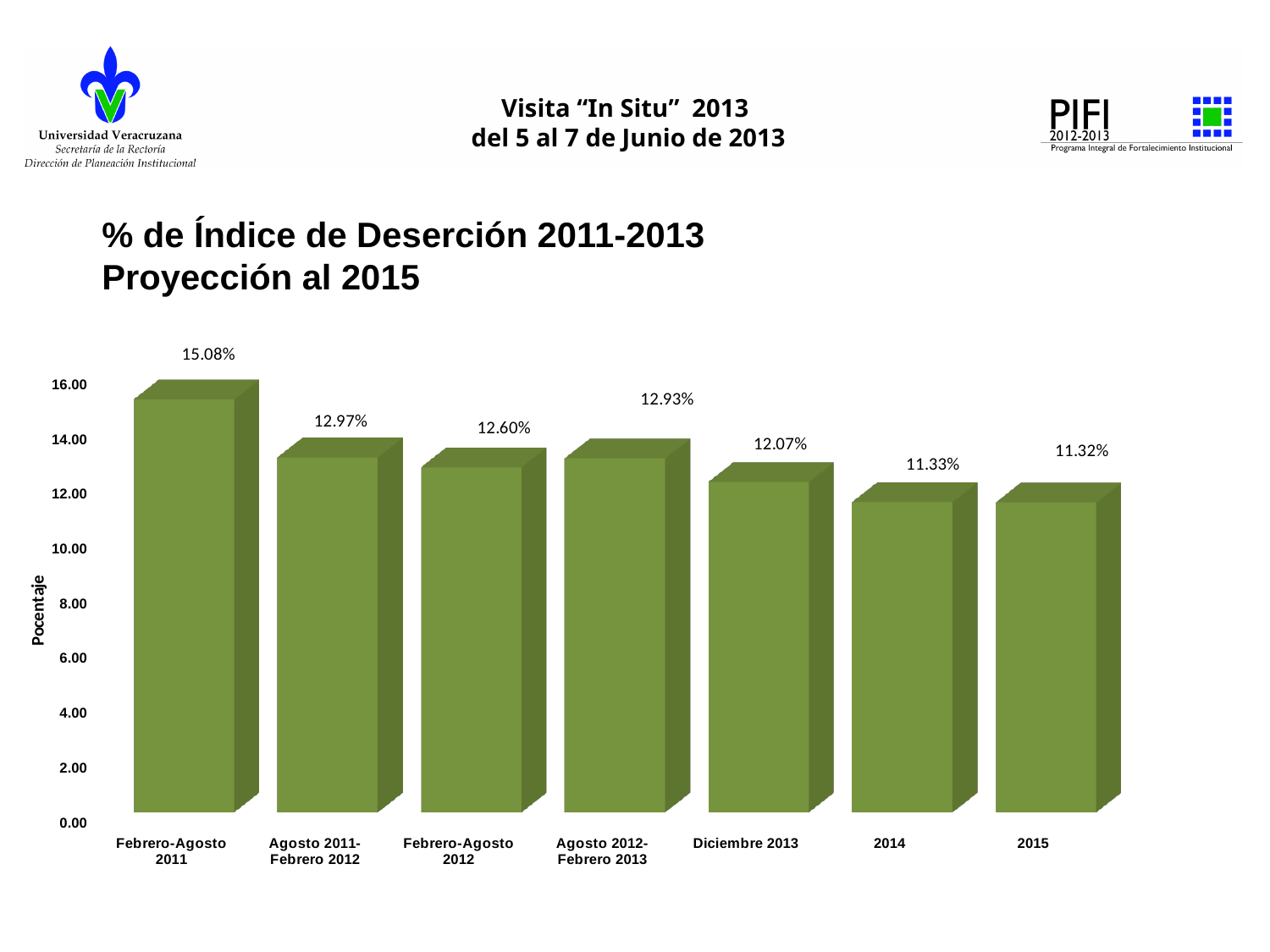
What is the label of the y axis? Pocentaje What is the value for Febrero-Agosto 2011? 15.08% What is the value for 2015? 11.32% Which category has the highest value? Febrero-Agosto 2011 Which is larger, the value for Febrero-Agosto 2012 or the value for Agosto 2012-Febrero 2013? Agosto 2012-Febrero 2013 What is the value for Agosto 2012-Febrero 2013? 12.93% Is the value for 2014 greater or less than 12.00? less What is the value for Diciembre 2013? 12.07% Do the values generally rise or fall from Febrero-Agosto 2011 to 2015? fall How many categories are shown on the x axis? 7 What kind of chart is shown on the slide? bar chart What is the difference between the values for Febrero-Agosto 2011 and Agosto 2011-Febrero 2012? 2.11%